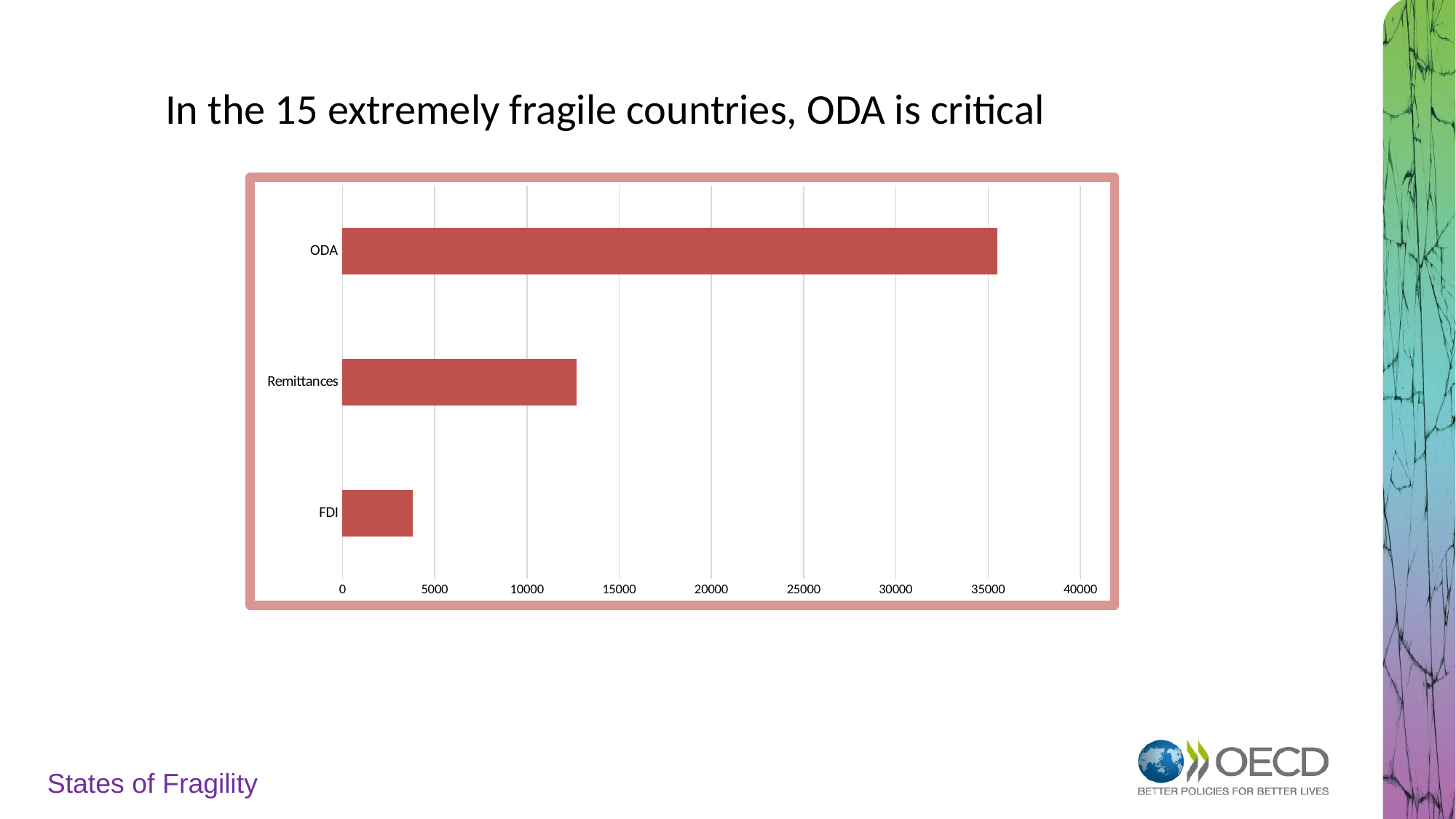
What kind of chart is shown on the slide? bar chart Which is larger, the value for ODA or the value for Remittances? ODA Is the value for FDI greater or less than 5000? less What is the title of the slide containing the chart? In the 15 extremely fragile countries, ODA is critical What is the highest value shown on the horizontal axis of the chart? 40000 Is the value for Remittances greater or less than 15000? less Which category has the highest value? ODA How many categories are plotted in the chart? 3 Which category has the lowest value? FDI Is the value for ODA greater or less than 35000? greater Which is larger, the value for Remittances or the value for FDI? Remittances